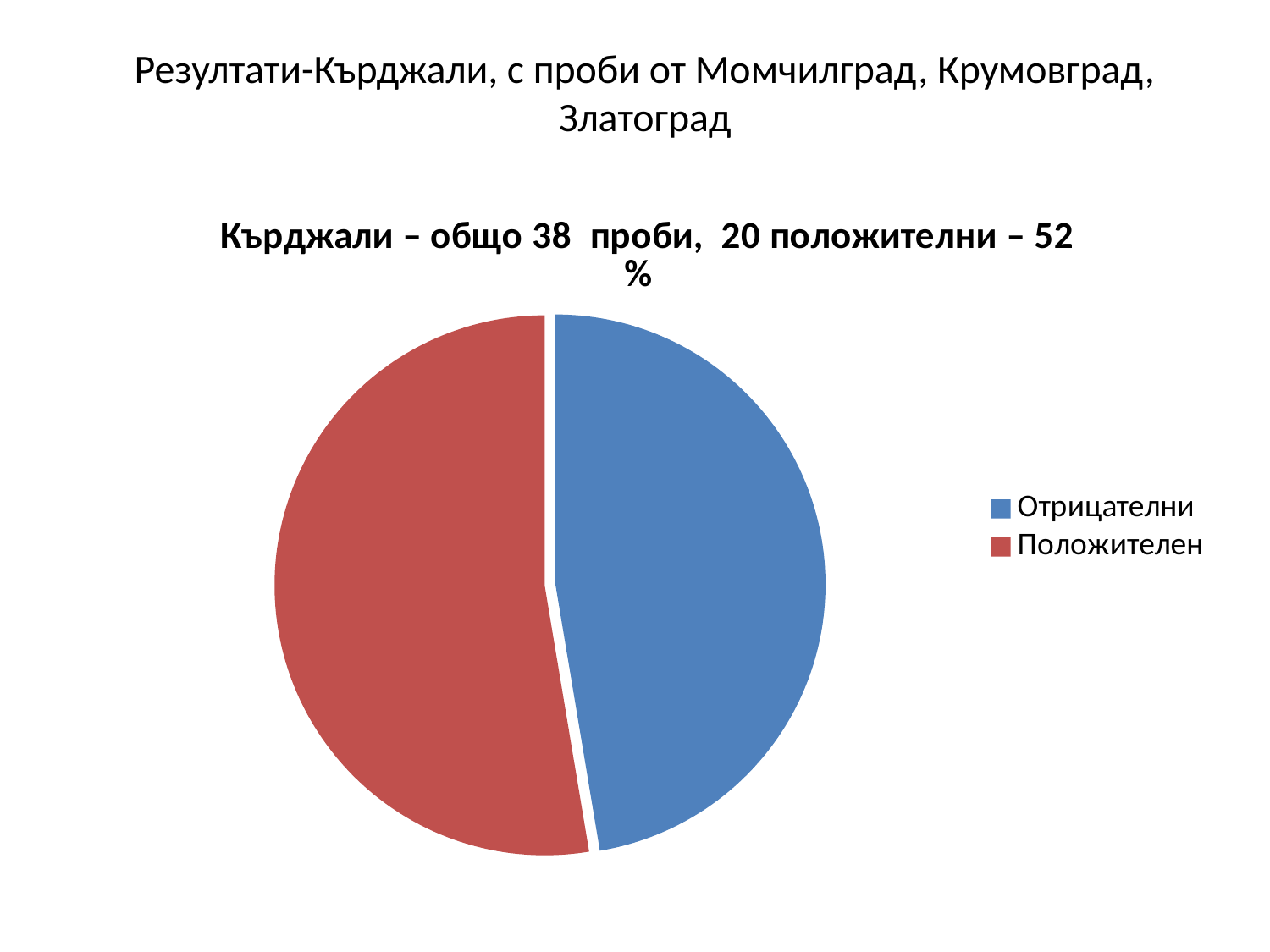
What is the title of the pie chart? Кърджали – общо 38 проби, 20 положителни – 52 % According to the chart title, how many samples in total were tested in Кърджали? 38 Which category has the largest slice in the pie chart? Положителен What kind of chart is shown on the slide? pie chart What share of the pie do the positive samples (Положителен) represent, according to the chart title? 52 % According to the chart title, how many samples were positive? 20 Which slice is larger in the pie chart, Отрицателни or Положителен? Положителен How many entries does the legend of the pie chart list? 2 How many slices does the pie chart have? 2 Which category has the smallest slice in the pie chart? Отрицателни Which colour represents Отрицателни in the pie chart? blue